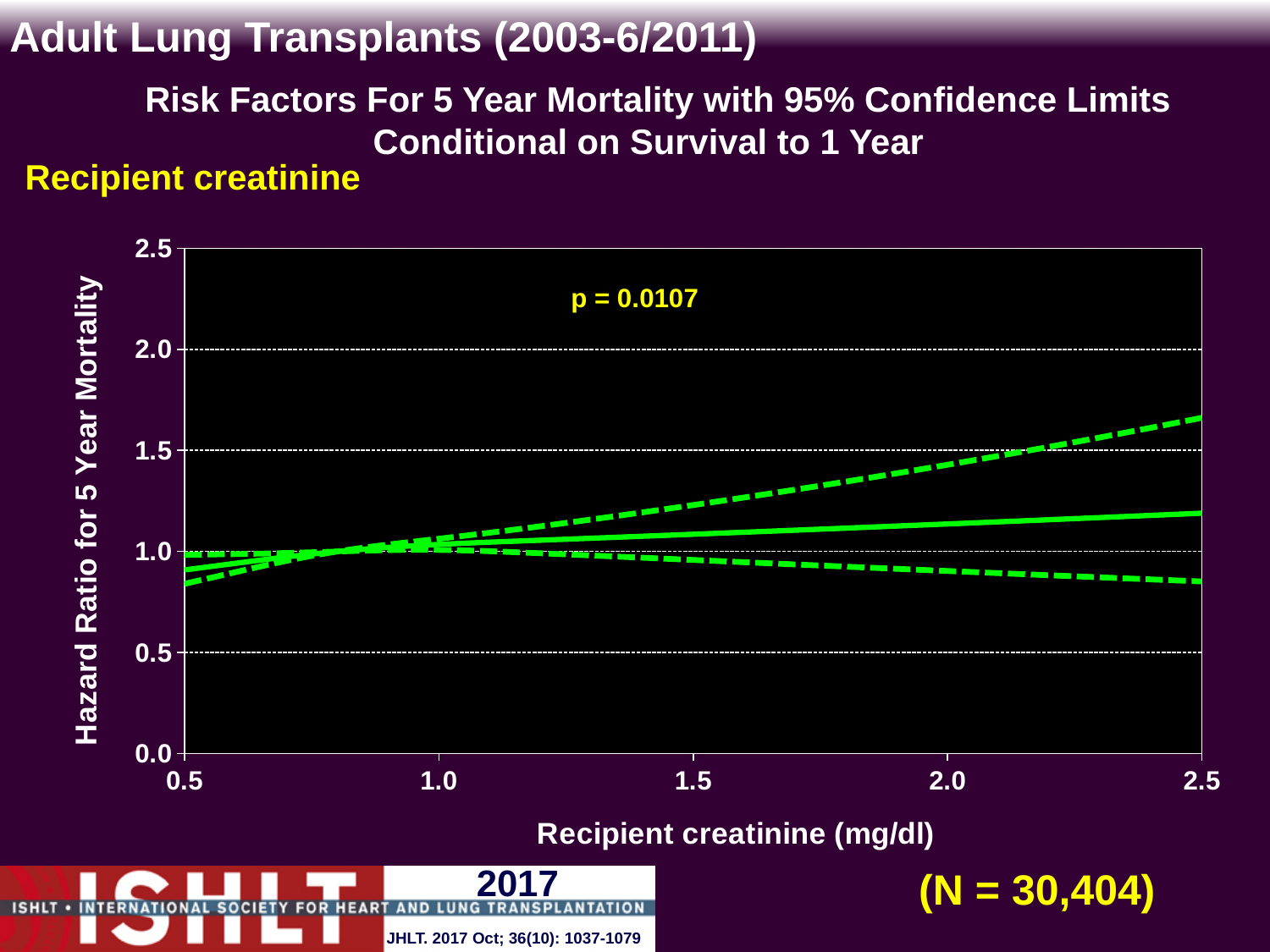
Is the upper dashed confidence limit at a recipient creatinine of 2.5 mg/dl greater or less than 2.0? less What kind of chart is shown on the slide? line chart What is the label of the x axis? Recipient creatinine (mg/dl) Is the lower dashed confidence limit at a recipient creatinine of 2.5 mg/dl greater or less than 1.0? less Does the solid hazard ratio line rise or fall as recipient creatinine increases from 0.5 to 2.5 mg/dl? rise How many lines are plotted on the chart? 3 Is the hazard ratio on the solid line at a recipient creatinine of 2.5 mg/dl greater or less than 1.0? greater What is the sample size (N) shown on the slide? 30,404 What is the label of the y axis? Hazard Ratio for 5 Year Mortality What p-value is printed on the chart? p = 0.0107